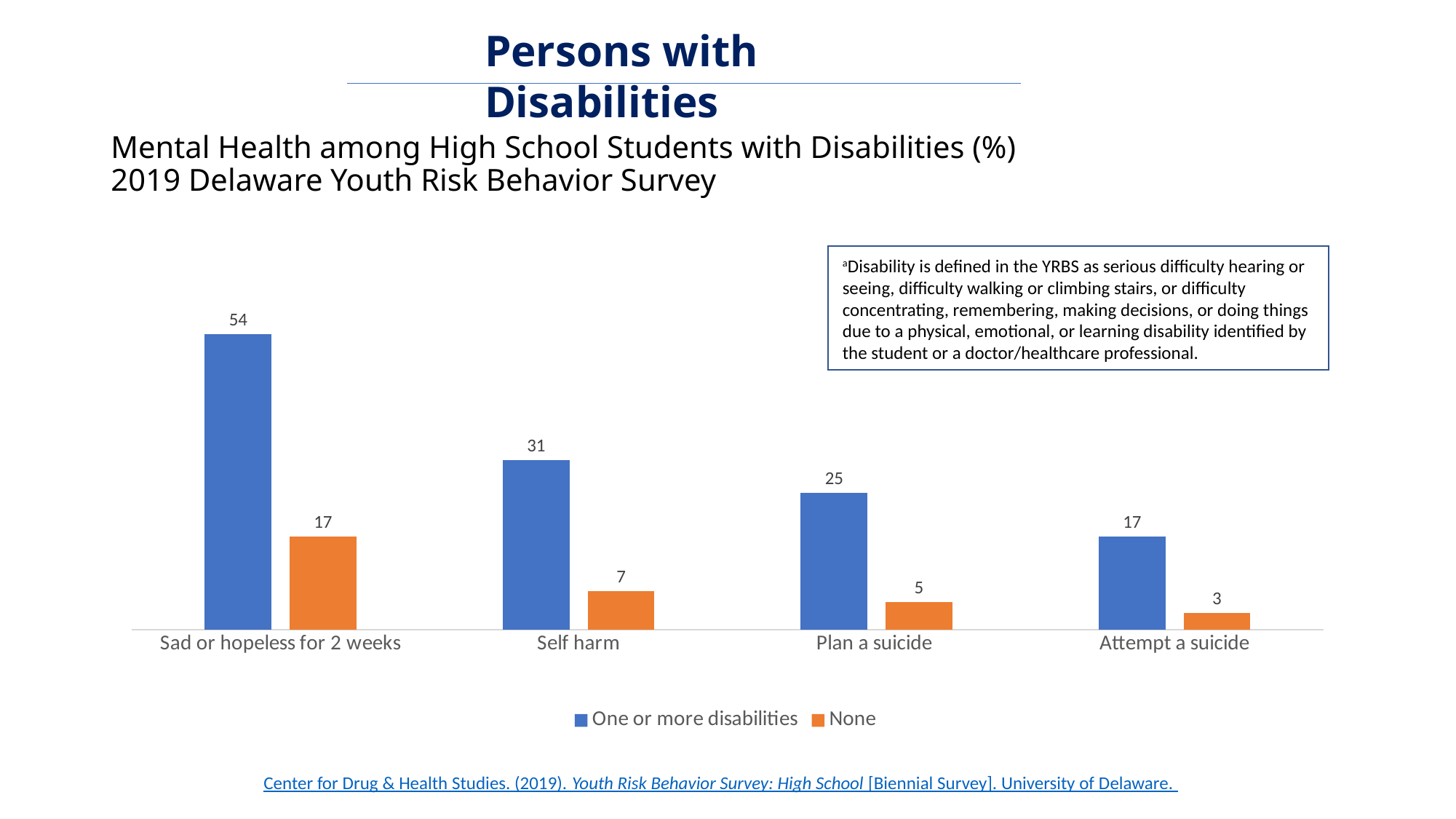
What is the value for 'None' in the 'Self harm' category? 7 What is the value for 'One or more disabilities' in the 'Sad or hopeless for 2 weeks' category? 54 What kind of chart is shown on the slide? Bar chart How many series does the legend list? 2 What is the difference between 'One or more disabilities' and 'None' in the 'Plan a suicide' category? 20 How many categories are shown on the x axis? 4 What is the value for 'One or more disabilities' in the 'Attempt a suicide' category? 17 Do the values for 'One or more disabilities' rise or fall from left to right along the x axis? Fall Which category has the lowest value for 'None'? Attempt a suicide Which is larger in the 'Self harm' category: 'One or more disabilities' or 'None'? One or more disabilities Which colour represents the 'None' series in the chart? Orange Which category has the highest value for 'One or more disabilities'? Sad or hopeless for 2 weeks